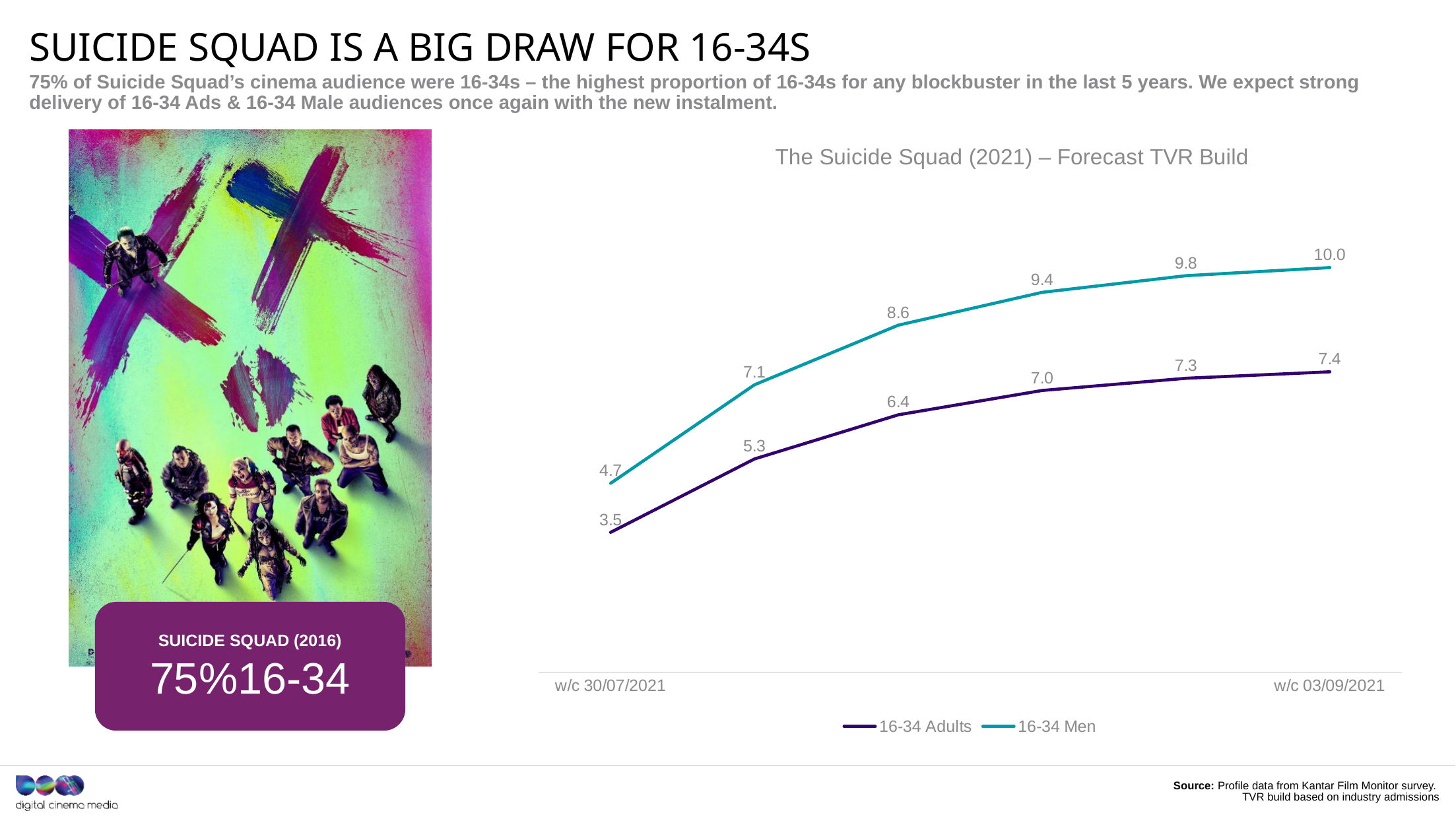
What is the value for 16-34 Adults at w/c 03/09/2021? 7.4 What is the value for 16-34 Men at w/c 30/07/2021? 4.7 What is the value for 16-34 Men at w/c 03/09/2021? 10.0 What is the lowest value in the 16-34 Men series? 4.7 What is the value for 16-34 Adults at w/c 30/07/2021? 3.5 What is the difference between 16-34 Men and 16-34 Adults at w/c 03/09/2021? 2.6 Which series is higher at w/c 30/07/2021, 16-34 Adults or 16-34 Men? 16-34 Men How many series does the legend list? 2 Do the values for 16-34 Adults rise or fall from w/c 30/07/2021 to w/c 03/09/2021? rise What is the highest value reached by the 16-34 Adults series? 7.4 What type of chart is shown on the slide? line chart How many data points are plotted for the 16-34 Men series? 6